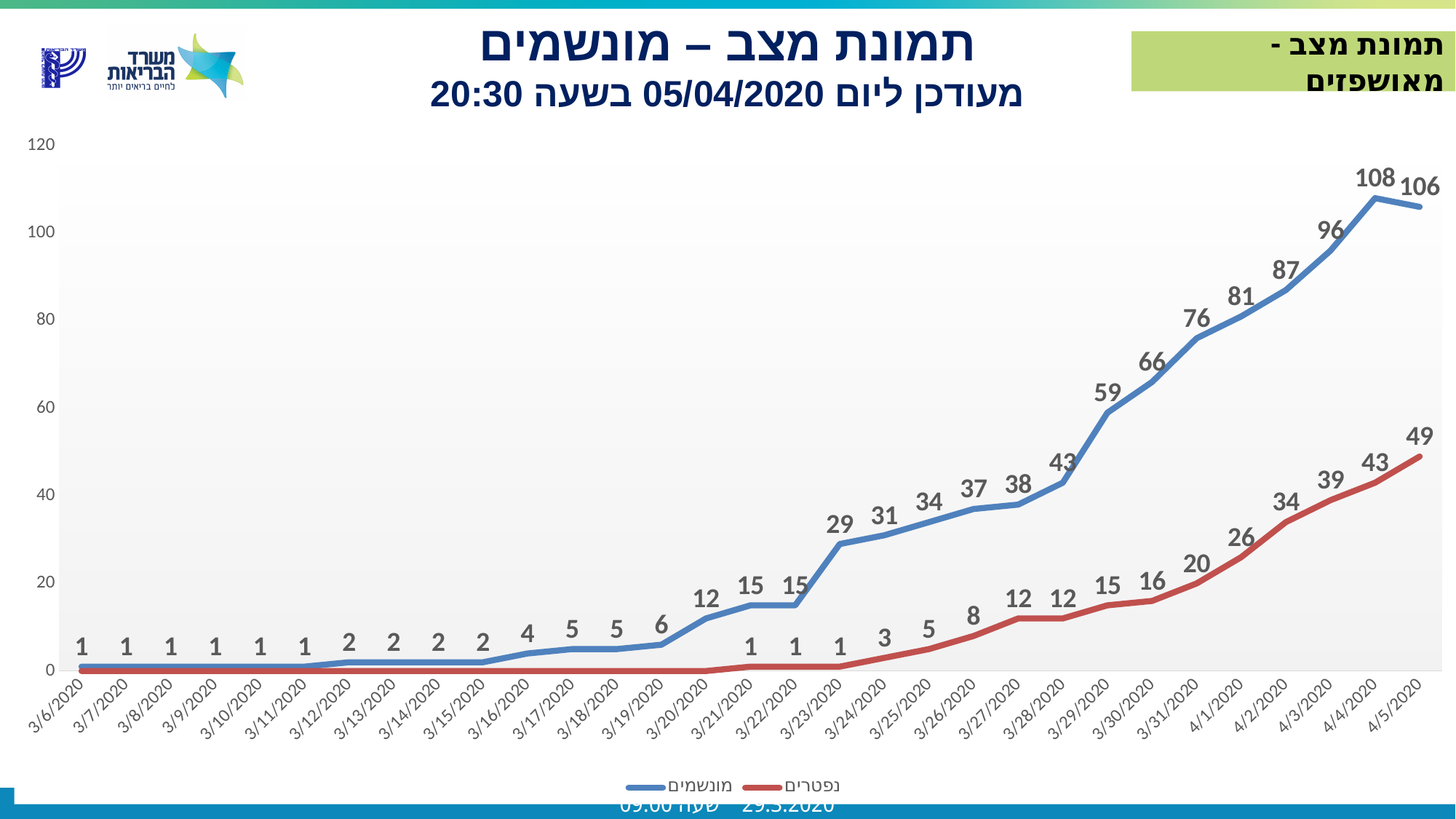
How many dates are shown on the x axis? 31 What type of chart is shown on the slide? line chart How many series does the legend list? 2 What colour is the line for the נפטרים series? red What is the value of the מונשמים series on 4/4/2020? 108 Is the value of the מונשמים series on 4/3/2020 greater or less than 100? less On which date does the מונשמים series reach its highest value? 4/4/2020 What is the value of the מונשמים series on 3/23/2020? 29 What is the difference between the מונשמים value and the נפטרים value on 4/5/2020? 57 Which series has the larger value on 3/29/2020, מונשמים or נפטרים? מונשמים Does the נפטרים series generally rise or fall from 3/21/2020 to 4/5/2020? rise What is the value of the נפטרים series on 4/5/2020? 49